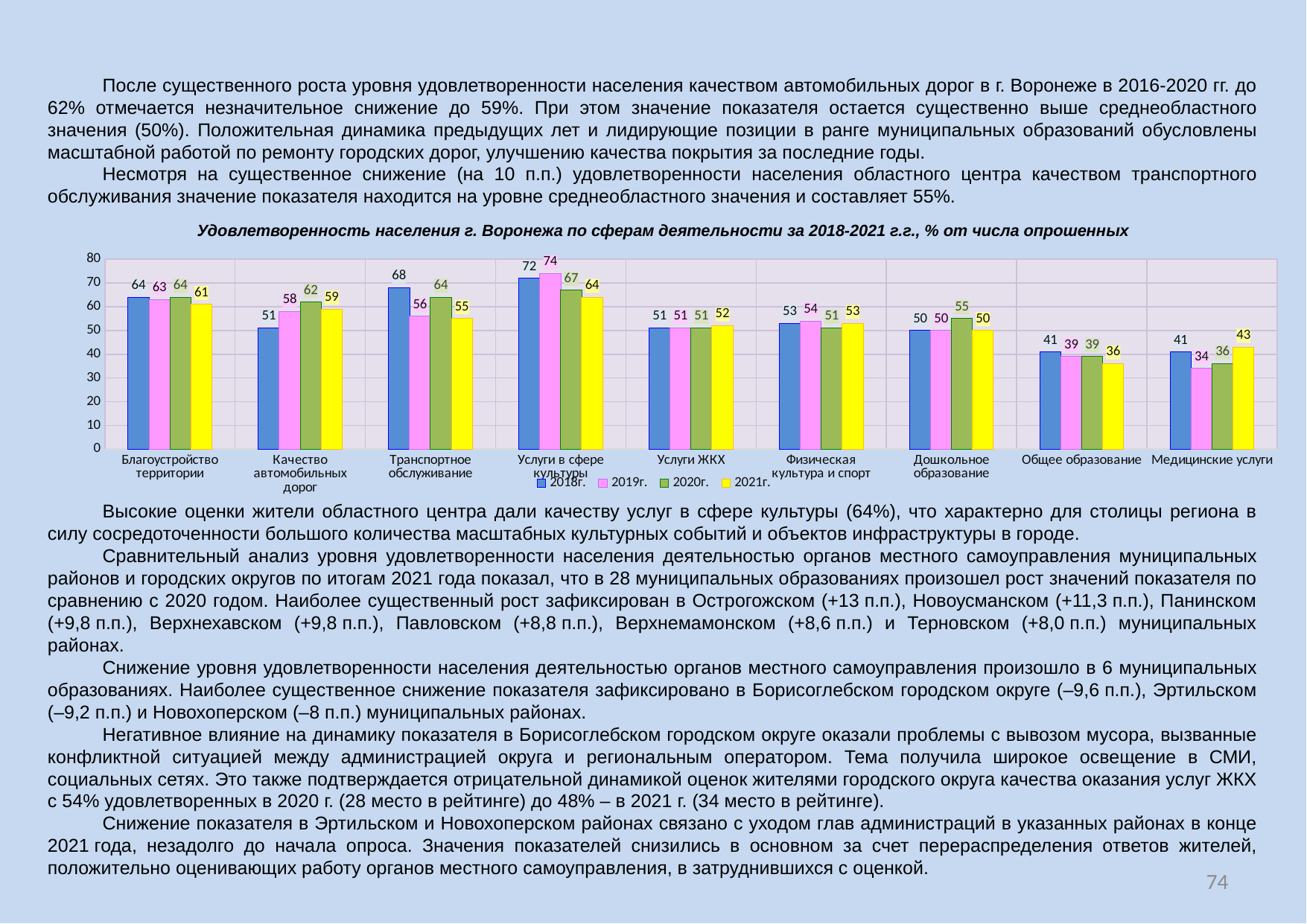
Сколько рядов данных указано в легенде диаграммы? 4 Каким цветом на диаграмме обозначен 2021 г.? Жёлтым Какое значение показателя для категории «Качество автомобильных дорог» в 2020 г.? 62 Какое значение показателя для категории «Услуги в сфере культуры» в 2021 г.? 64 В какой категории значение за 2021 г. самое низкое? Общее образование Что больше: значение для «Дошкольное образование» в 2020 г. или для «Физическая культура и спорт» в 2020 г.? Дошкольное образование Сколько категорий (сфер деятельности) показано на диаграмме? 9 Как изменяется значение для «Общее образование» с 2018 г. по 2021 г. — растёт или снижается? Снижается Какого типа эта диаграмма? Столбчатая (bar chart) Какое значение показателя для категории «Медицинские услуги» в 2019 г.? 34 В какой категории значение за 2019 г. самое высокое? Услуги в сфере культуры На сколько значение для «Транспортное обслуживание» в 2018 г. больше значения в 2021 г.? 13